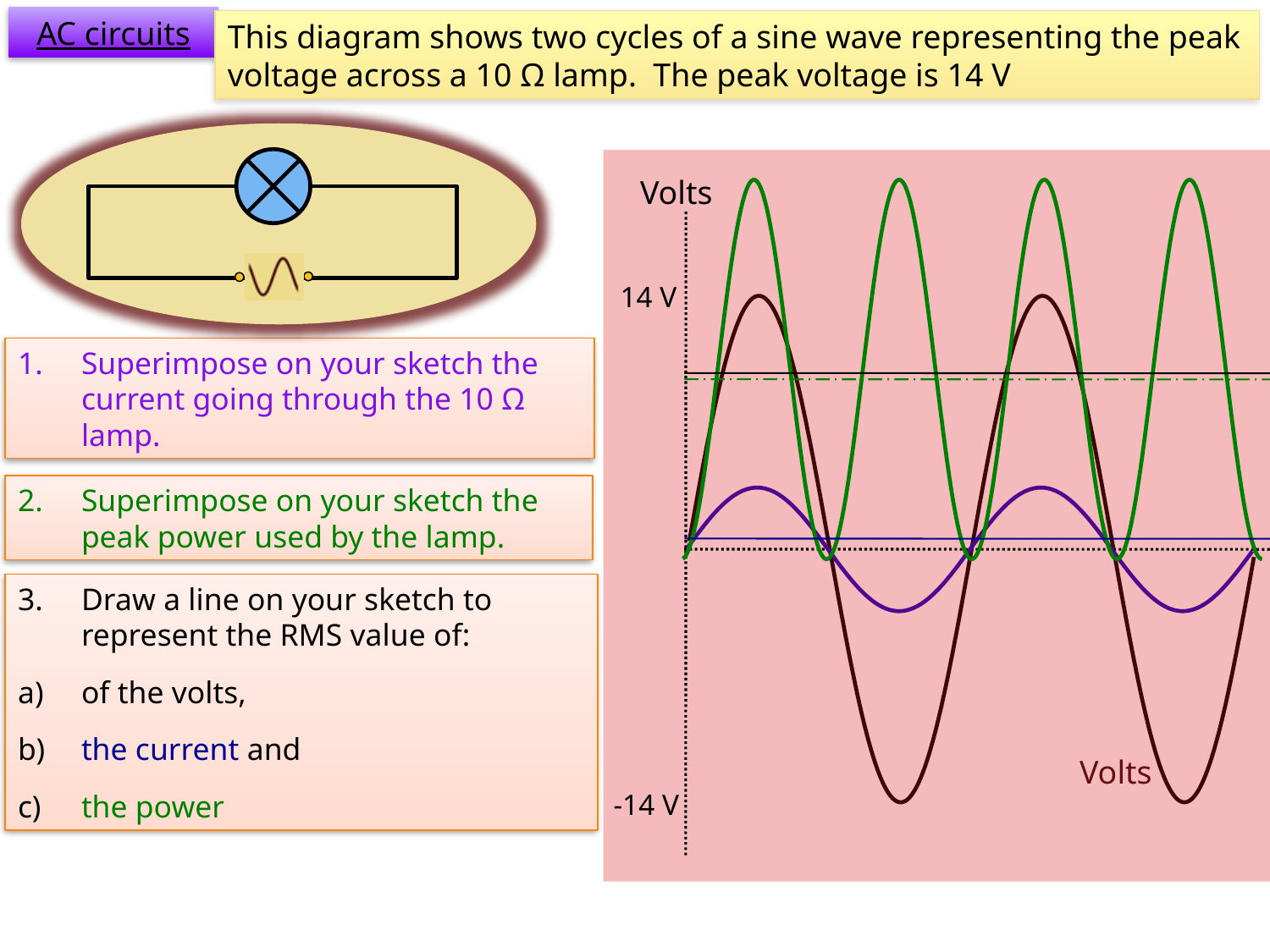
Which of the two is larger: the peak of the dark red curve or the peak of the purple curve? the dark red curve Is the peak of the green curve greater or less than 14 V? greater Which curve reaches the highest peak on the chart: the green, the dark red or the purple? green What kind of chart is shown on the right of the slide? line chart What is the lowest value reached by the dark red curve labelled Volts? -14 V Is the peak of the purple curve greater or less than 14 V? less How many complete cycles of the dark red voltage sine wave are shown? 2 What label is written at the top of the vertical axis of the chart? Volts What colour is the curve labelled Volts on the chart? dark red What is the peak value of the dark red curve labelled Volts? 14 V Which curve has the smallest amplitude: the green, the dark red or the purple? purple How many peaks does the green curve have? 4